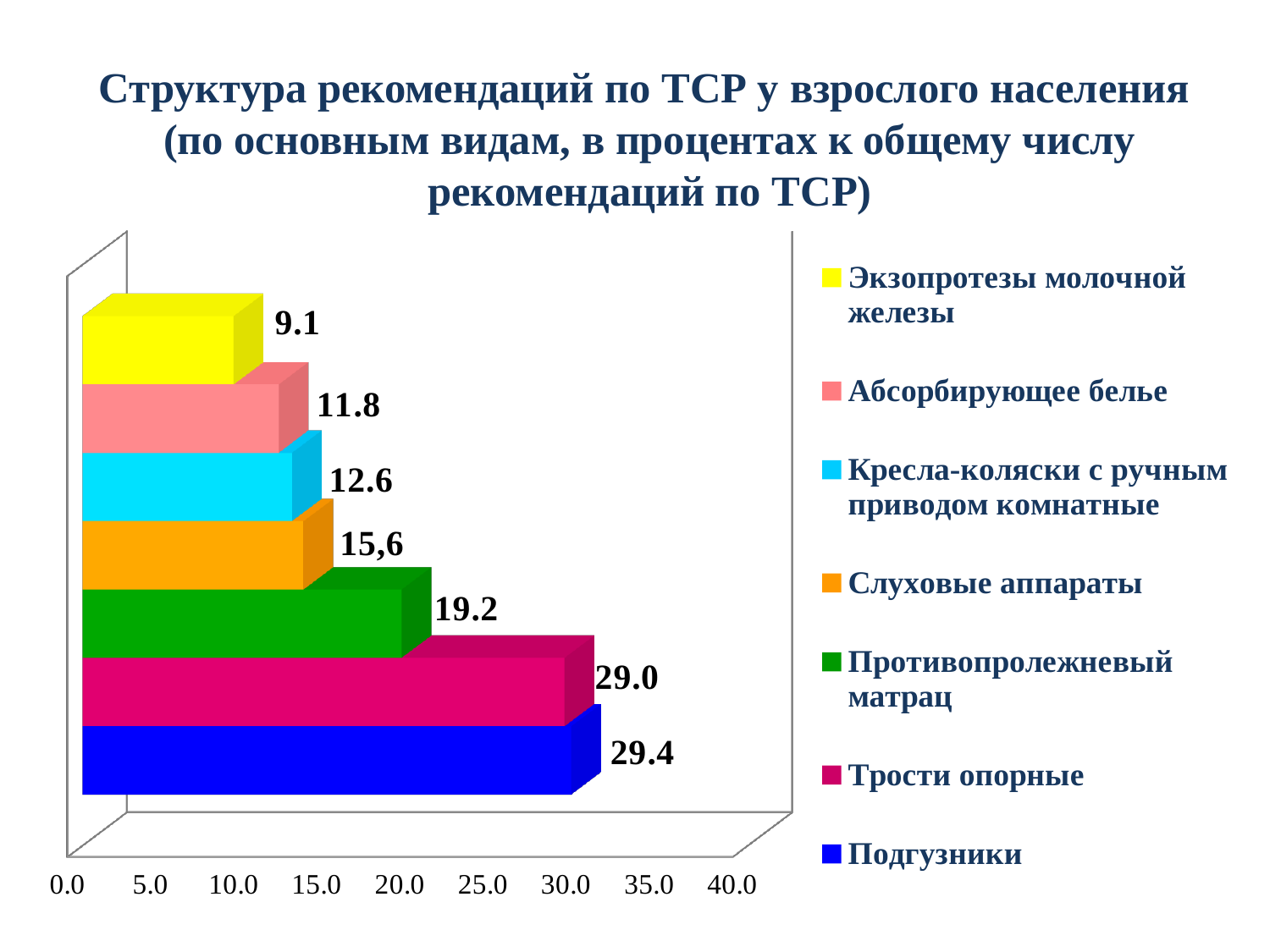
What kind of chart is shown on the slide? bar chart How many entries does the legend list? 7 Which category has the lowest value? Экзопротезы молочной железы What is the difference between the values for Трости опорные and Противопролежневый матрац? 9.8 What is the value for Подгузники? 29.4 What is the value for Экзопротезы молочной железы? 9.1 Is the value for Трости опорные greater or less than 25.0? greater What is the value for Кресла-коляски с ручным приводом комнатные? 12.6 What is the value for Слуховые аппараты? 15,6 How many bars are shown in the chart? 7 Which category has the highest value? Подгузники Which is larger, the value for Абсорбирующее белье or the value for Противопролежневый матрац? Противопролежневый матрац